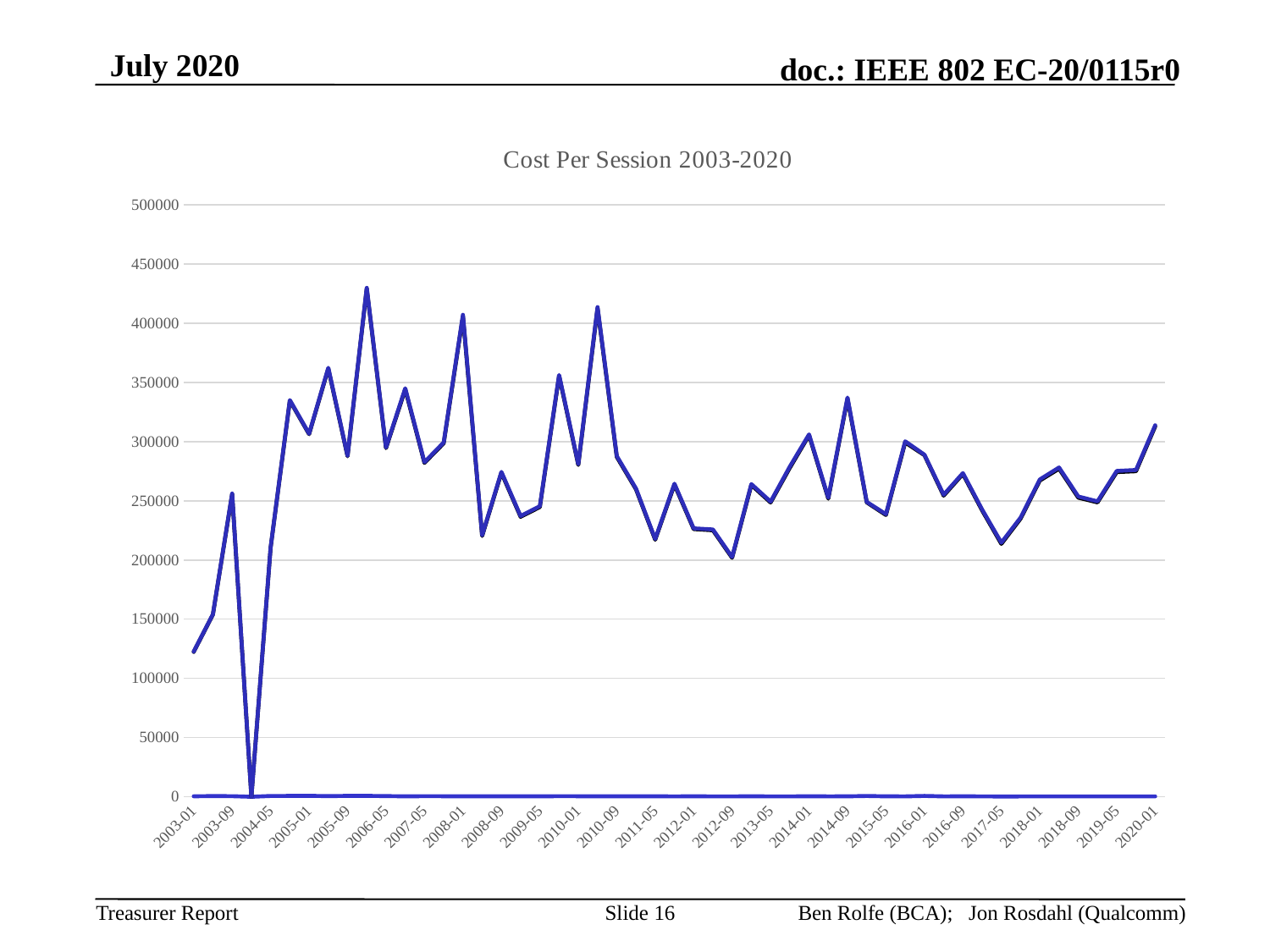
Is the value for 2003-09 greater or less than 200000? greater What kind of chart is shown on the slide? line chart What is the title of the chart? Cost Per Session 2003-2020 Which has the larger value, 2014-09 or 2017-05? 2014-09 Is the value for 2005-09 greater or less than 250000? greater Is the value for 2017-05 greater or less than 250000? less Between 2003-01 and 2003-09, does the value rise or fall? rise Which has the larger value, 2003-01 or 2003-09? 2003-09 What is the highest value shown on the y axis? 500000